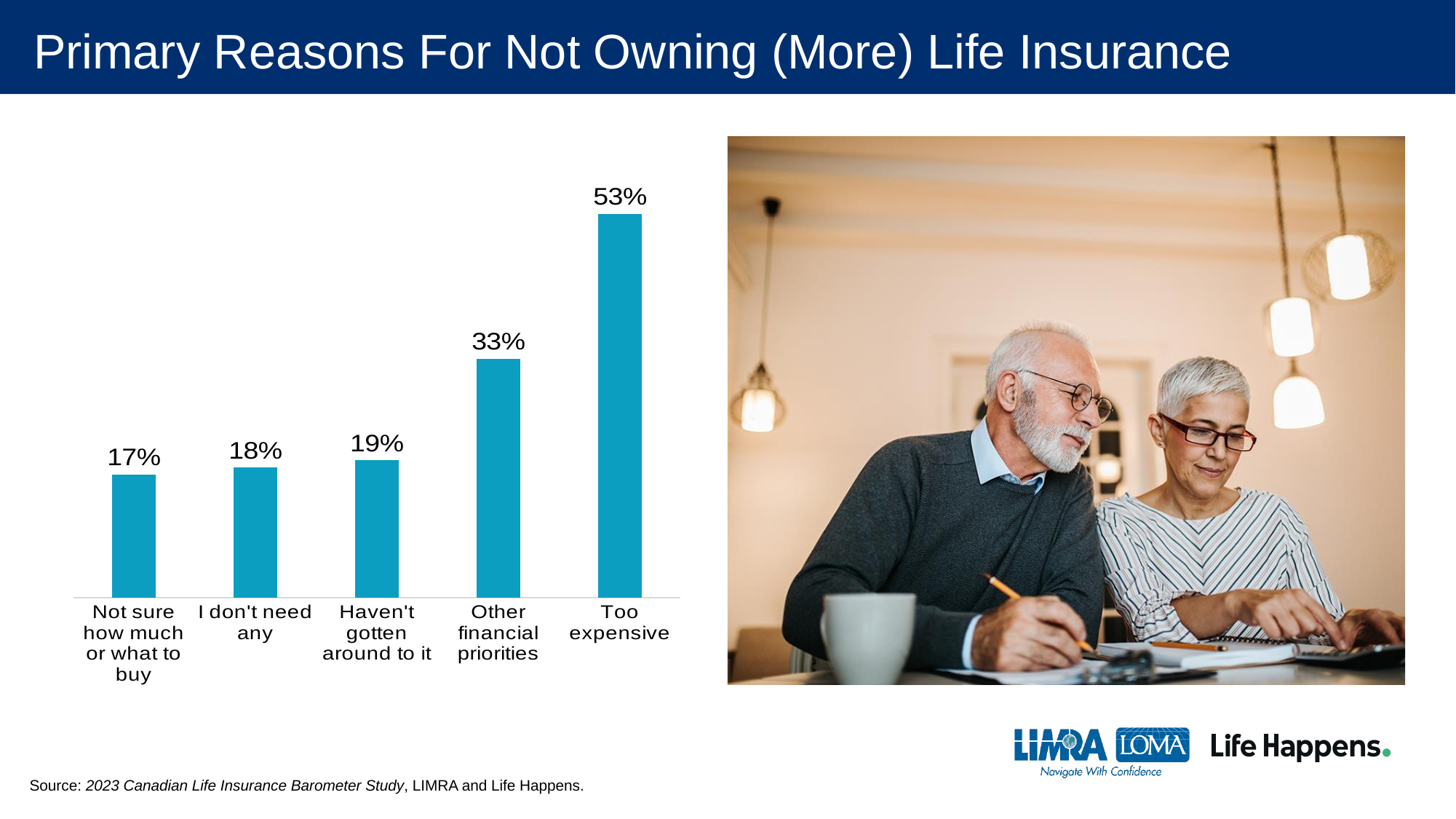
What is the value for "Other financial priorities"? 33% What is the difference between "Too expensive" and "Other financial priorities"? 20% What is the value for "Haven't gotten around to it"? 19% What percentage of respondents cited "Too expensive" as a reason for not owning (more) life insurance? 53% How many reasons (categories) are shown in the chart? 5 What type of chart is shown on the slide? Bar chart What is the title of the slide containing the chart? Primary Reasons For Not Owning (More) Life Insurance Which reason has the highest percentage? Too expensive Which is larger: "Other financial priorities" or "Haven't gotten around to it"? Other financial priorities Which reason has the lowest percentage? Not sure how much or what to buy What is the value for "Not sure how much or what to buy"? 17% What is the difference between "I don't need any" and "Not sure how much or what to buy"? 1%